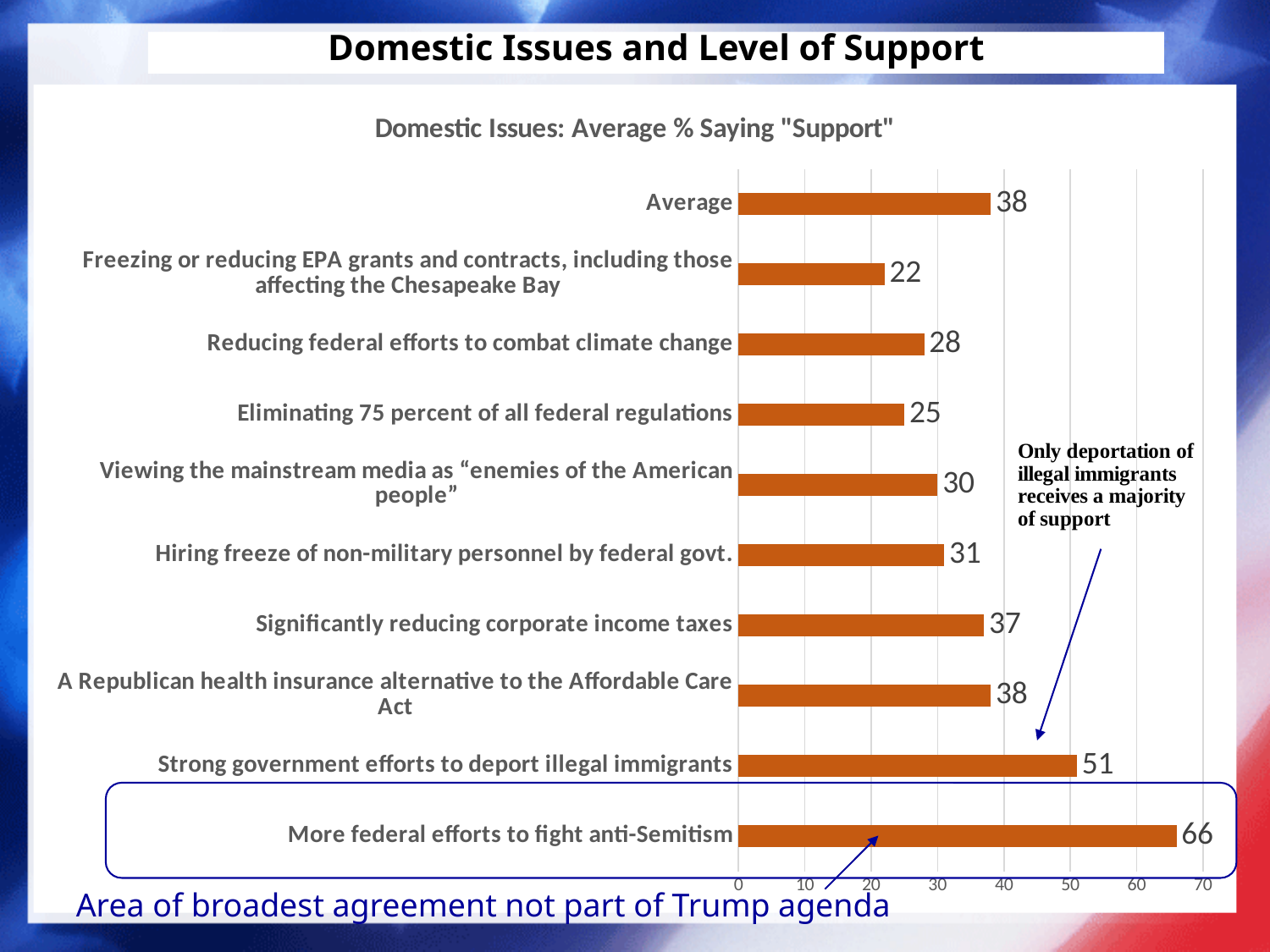
How many categories (bars) are shown in the chart? 10 Which is larger: the value for "Significantly reducing corporate income taxes" or the value for "Eliminating 75 percent of all federal regulations"? Significantly reducing corporate income taxes What is the value for "Average"? 38 What is the value for "Strong government efforts to deport illegal immigrants"? 51 What is the title of the chart? Domestic Issues: Average % Saying "Support" What is the difference between the value for "More federal efforts to fight anti-Semitism" and the value for "Strong government efforts to deport illegal immigrants"? 15 Which category has the highest value? More federal efforts to fight anti-Semitism What is the value for "Hiring freeze of non-military personnel by federal govt."? 31 What kind of chart is shown on the slide? Bar chart What is the value for "Reducing federal efforts to combat climate change"? 28 Which category has the lowest value? Freezing or reducing EPA grants and contracts, including those affecting the Chesapeake Bay Is the value for "Viewing the mainstream media as “enemies of the American people”" greater or less than 40? less